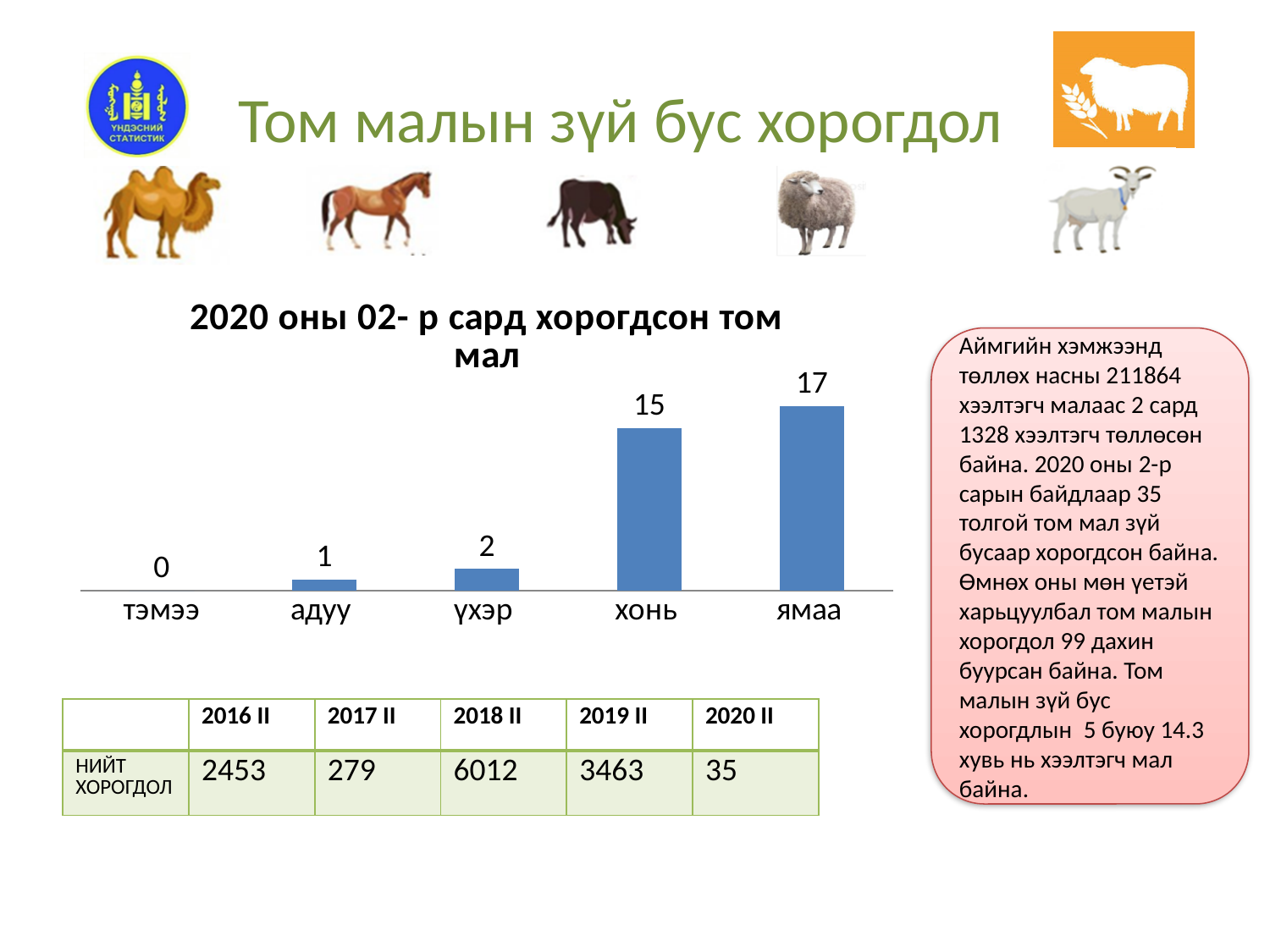
Which category has the highest value in the chart? ямаа What is the value for адуу in the chart? 1 What is the title of the chart? 2020 оны 02- р сард хорогдсон том мал What is the value for ямаа in the chart? 17 What is the difference between the values for ямаа and хонь? 2 What kind of chart is shown on the slide? bar chart What is the difference between the values for хонь and үхэр? 13 How many categories are shown on the x axis of the chart? 5 Which is larger, the value for үхэр or the value for адуу? үхэр What is the value for тэмээ in the chart? 0 What is the value for хонь in the chart? 15 Which category has the lowest value in the chart? тэмээ